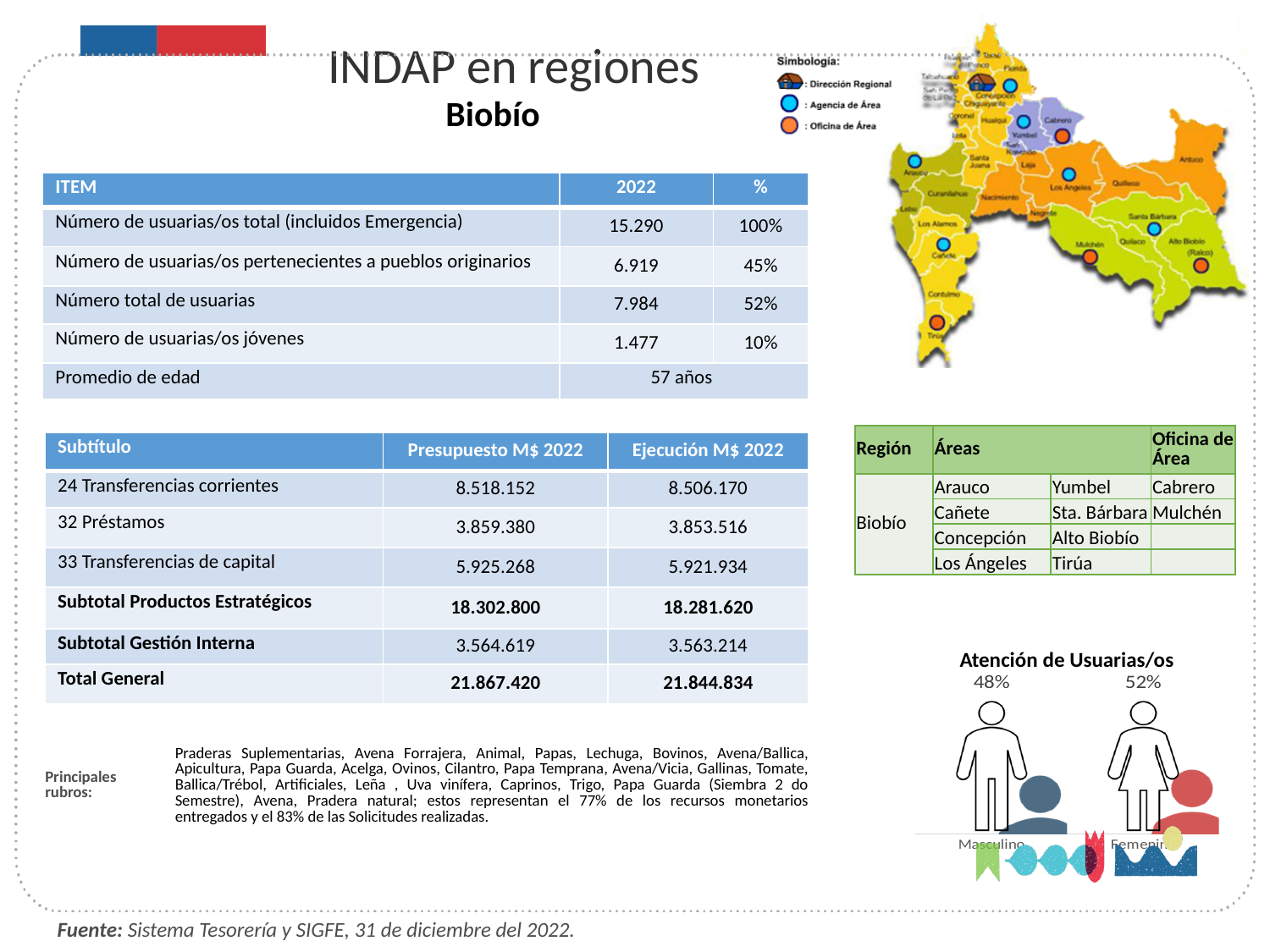
How many categories are shown in the 'Atención de Usuarias/os' chart? 2 In the 'Atención de Usuarias/os' chart, what is the value for Femenino? 52% What is the title of the chart in the lower right of the slide? Atención de Usuarias/os In the 'Atención de Usuarias/os' chart, which category has the higher value? Femenino In the 'Atención de Usuarias/os' chart, which category has the lower value? Masculino In the 'Atención de Usuarias/os' chart, what do the two percentages add up to? 100% What kind of chart is 'Atención de Usuarias/os'? pictogram (icon) chart In the 'Atención de Usuarias/os' chart, is the value for Masculino larger or smaller than the value for Femenino? smaller In the 'Atención de Usuarias/os' chart, is the value for Femenino greater or less than 50%? greater In the 'Atención de Usuarias/os' chart, what is the value for Masculino? 48% In the 'Atención de Usuarias/os' chart, what is the difference between the Femenino and Masculino values? 4%